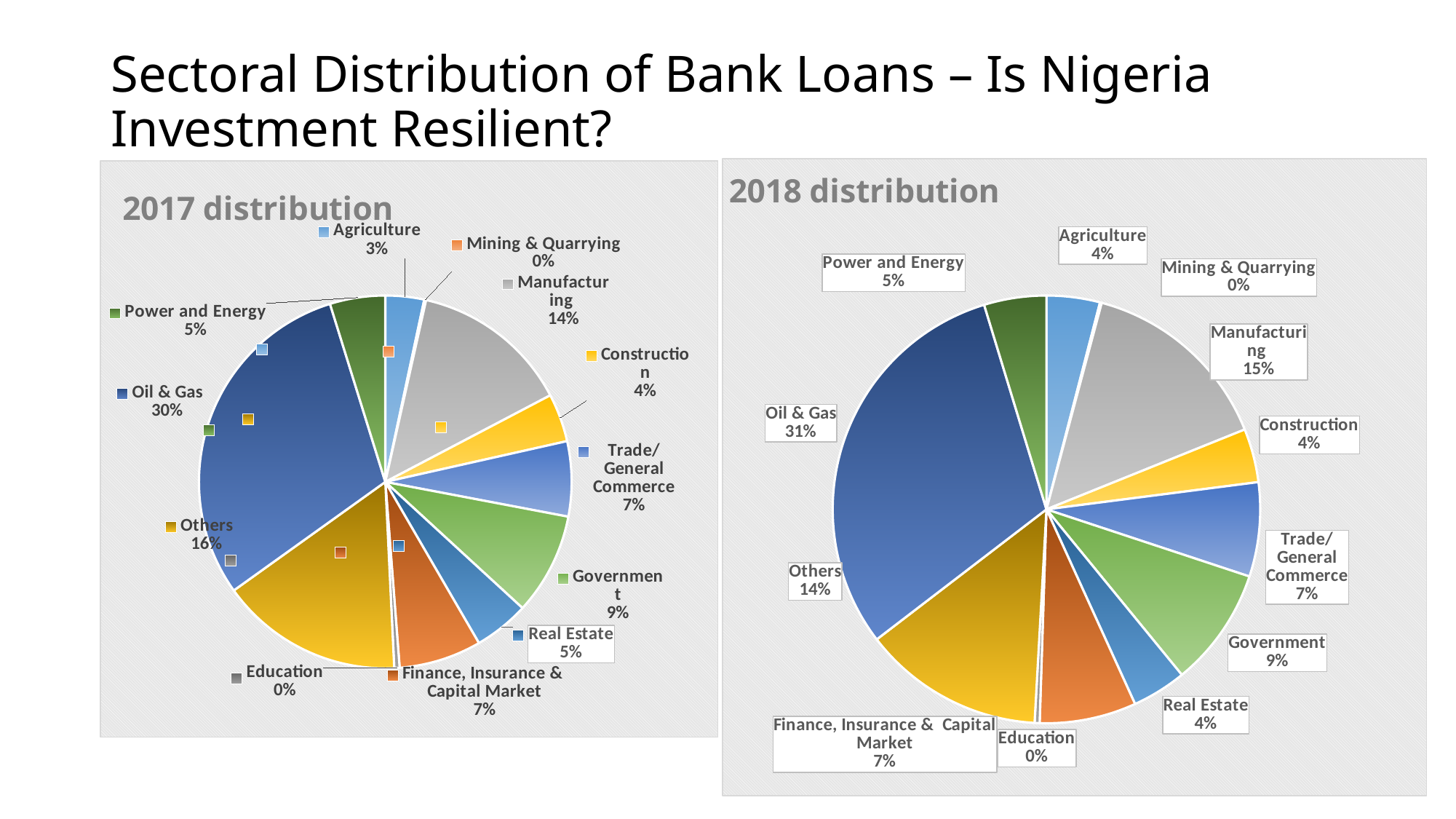
In the 2018 distribution chart, what share of bank loans went to Manufacturing? 15% In the 2017 distribution chart, what is the share for Real Estate? 5% In the 2018 distribution chart, which is larger, the share for Real Estate or the share for Trade/General Commerce? Trade/General Commerce In the 2018 distribution chart, what is the share for Others? 14% What type of chart is the 2017 distribution chart? Pie chart How many sectors are shown in the 2018 distribution chart? 12 In the 2017 distribution chart, what is the difference between the Others share and the Manufacturing share? 2% In the 2017 distribution chart, which sector has the largest share? Oil & Gas What is the title of the chart on the right side of the slide? 2018 distribution In the 2017 distribution chart, what share of bank loans went to Oil & Gas? 30% In the 2017 distribution chart, what is the share for Government? 9% In the 2018 distribution chart, which sector has the largest share? Oil & Gas